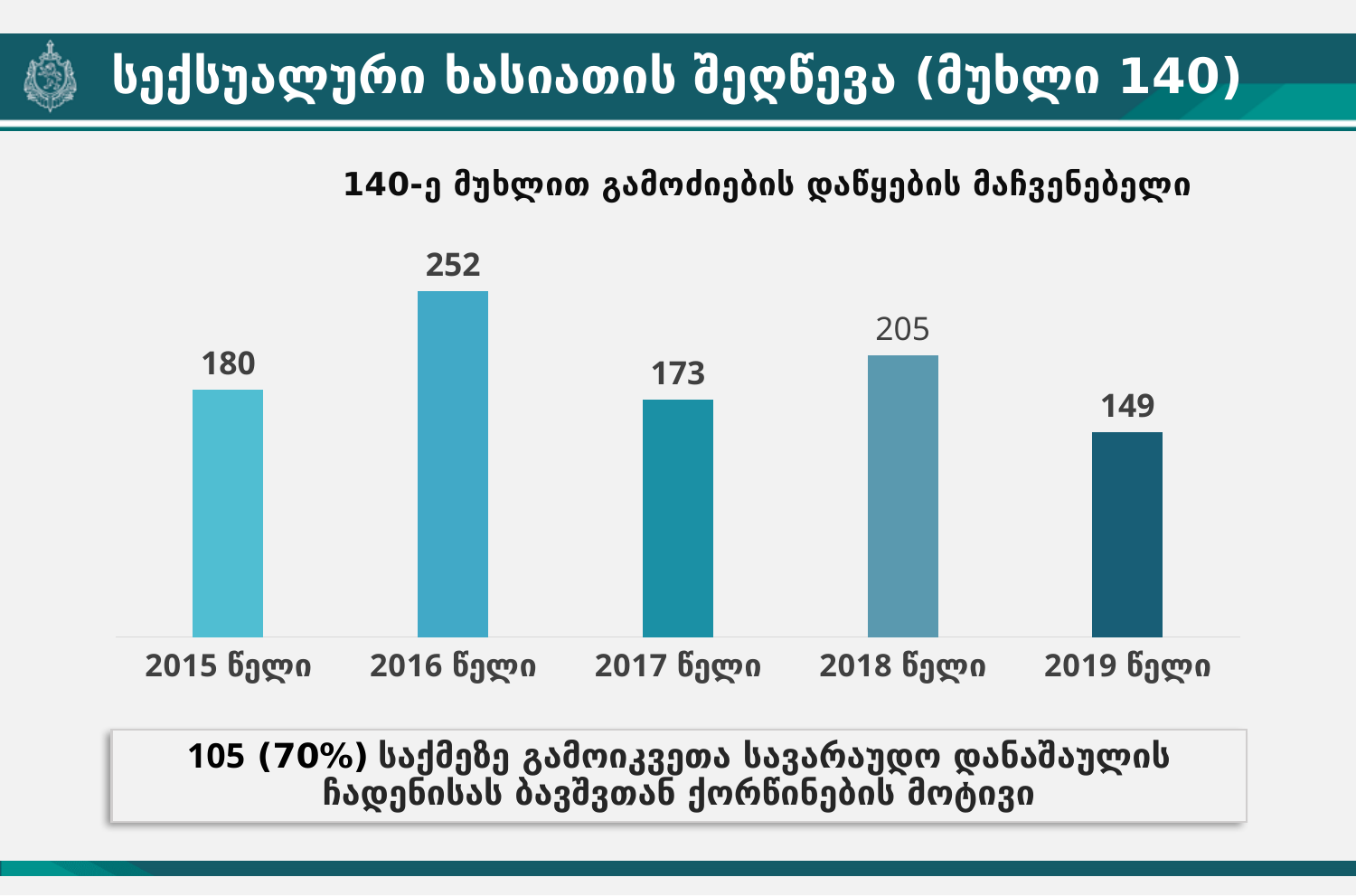
What is the value for 2019 წელი? 149 Which year has the lowest value? 2019 წელი What kind of chart is shown on the slide? bar chart What is the difference between the values for 2016 წელი and 2019 წელი? 103 What is the difference between the values for 2015 წელი and 2017 წელი? 7 What is the value for 2018 წელი? 205 Which year has the highest value? 2016 წელი What is the value for 2016 წელი? 252 Does the value fall or rise from 2018 წელი to 2019 წელი? fall How many years are shown on the chart? 5 Which is larger, the value for 2018 წელი or the value for 2015 წელი? 2018 წელი What is the title of the chart? 140-ე მუხლით გამოძიების დაწყების მაჩვენებელი